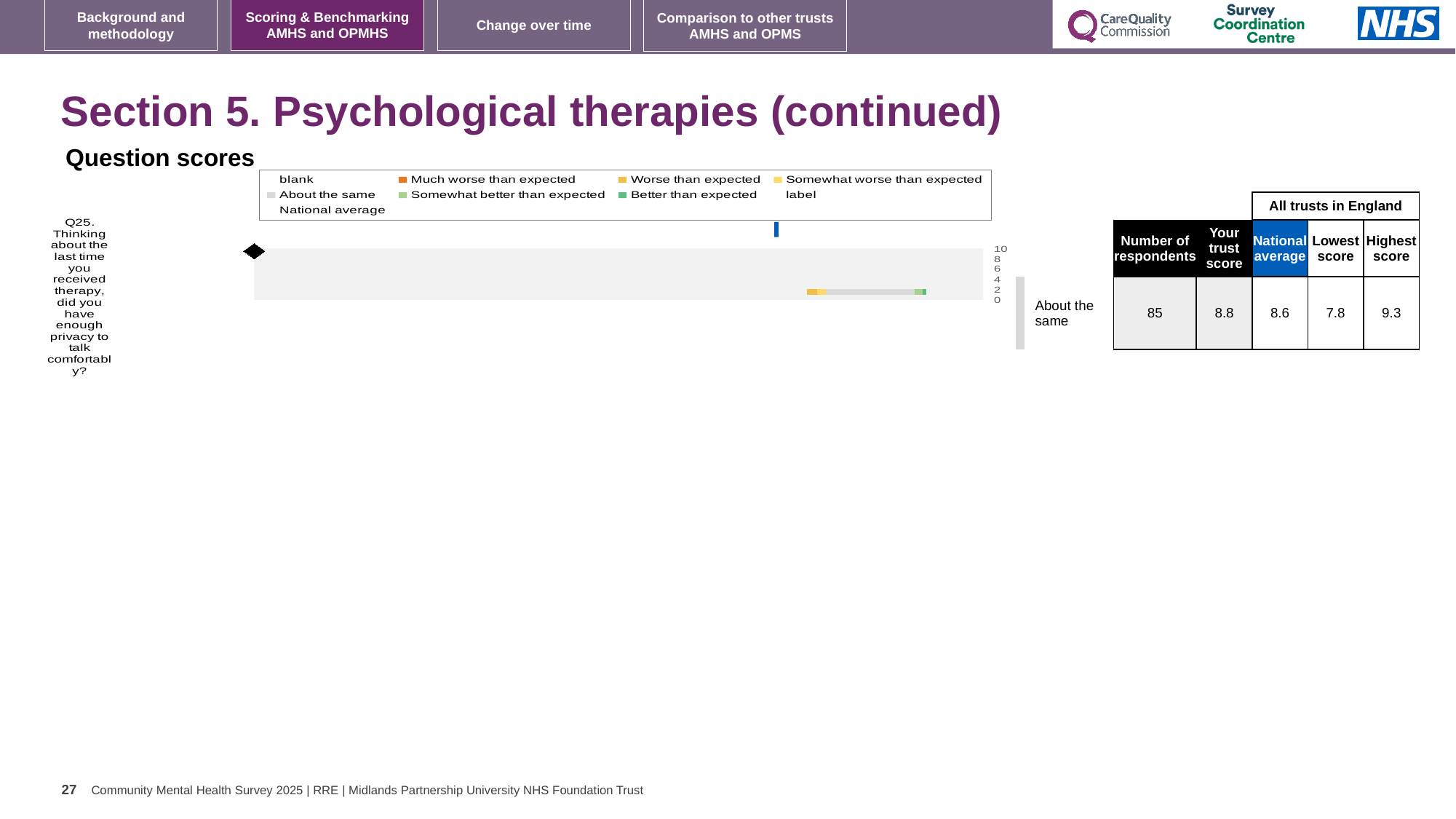
In the table beside the chart, what is the number of respondents for Q25? 85 Which question is plotted in the Question scores chart? Q25. Thinking about the last time you received therapy, did you have enough privacy to talk comfortably? In the table beside the chart, what is the national average for Q25? 8.6 In the table beside the chart, what is the trust score for Q25? 8.8 How many questions (categories) are plotted in the Question scores chart? 1 How many entries does the legend of the Question scores chart list? 9 In the table beside the chart, which is larger for Q25: the trust score or the national average? trust score What benchmark category is shown next to the Question scores chart for Q25? About the same In the table beside the chart, what is the difference between the highest score and the lowest score for Q25? 1.5 What kind of chart is shown under 'Question scores'? bar chart What is the highest tick value shown on the axis of the Question scores chart? 10